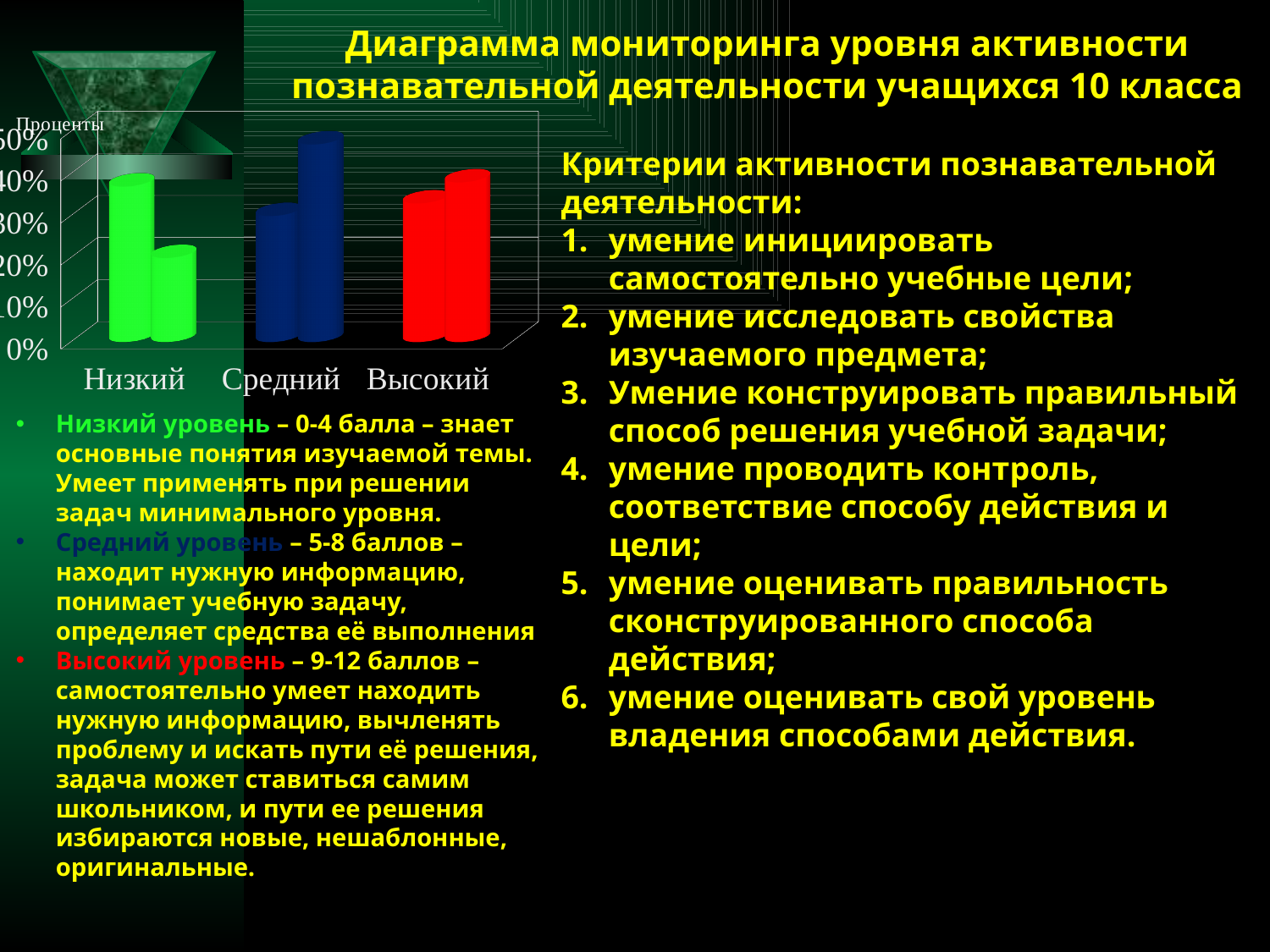
Is the value of the right bar for Средний greater or less than 40%? greater Is the value of the left bar for Низкий greater or less than 30%? greater Is the value of the right bar for Низкий greater or less than 30%? less Within the Средний category, which bar is taller, the left one or the right one? the right one What is the label of the vertical axis of the chart? Проценты What are the category labels on the x axis of the chart? Низкий, Средний, Высокий What kind of chart is shown on the slide? bar chart How many categories are shown on the x axis of the chart? 3 Within the Низкий category, which bar is taller, the left one or the right one? the left one